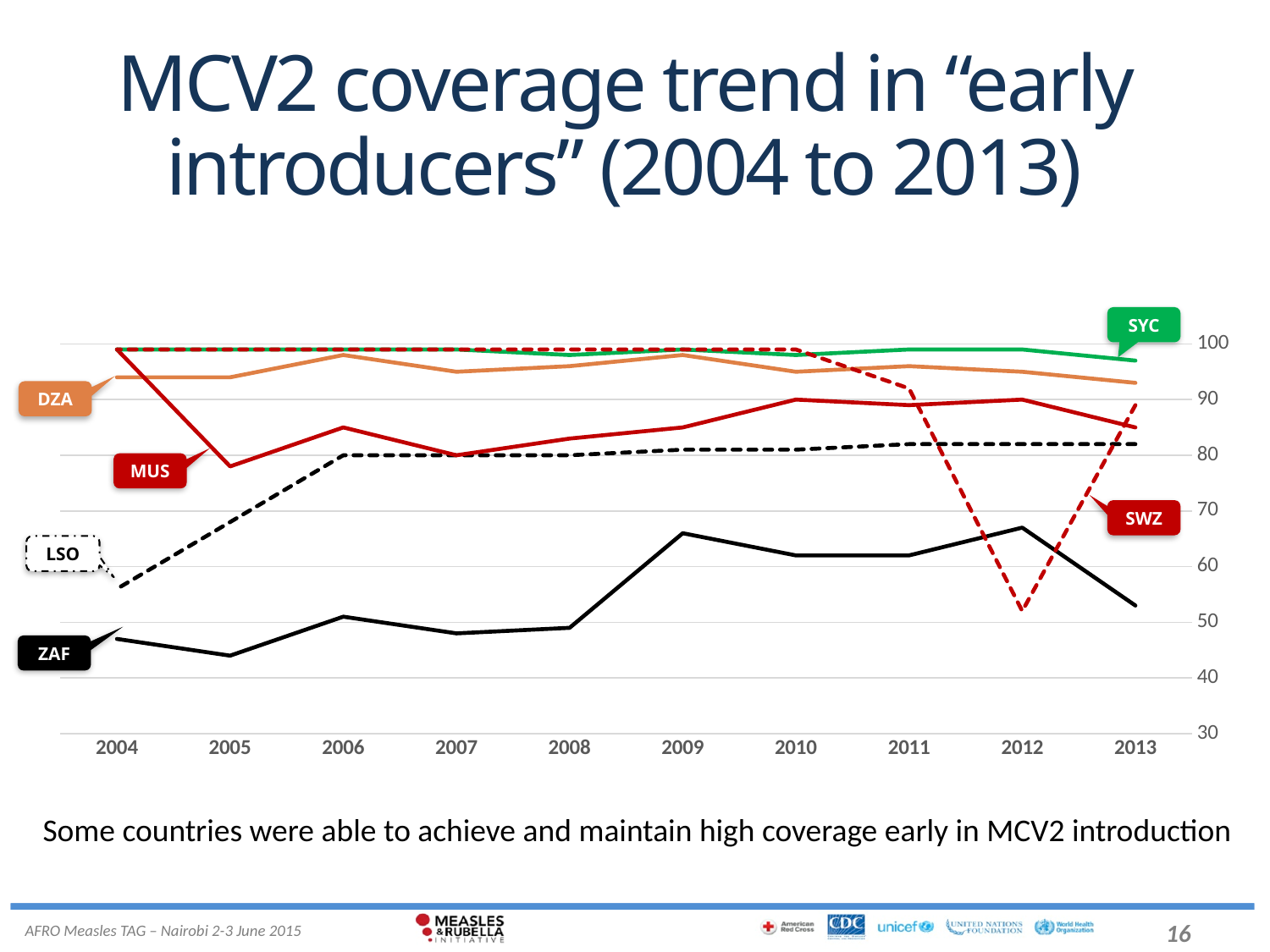
What kind of chart is shown on the slide? line chart What is the title of the chart on the slide? MCV2 coverage trend in "early introducers" (2004 to 2013) Which country has the highest MCV2 coverage in 2013? SYC How many years are shown along the x axis of the chart? 10 Is the value for DZA in 2013 greater or less than 90? greater Is the value for SWZ in 2012 greater or less than 60? less How many countries (series) are plotted on the chart? 6 Does the LSO line rise or fall from 2004 to 2013? rise Is the value for ZAF in 2004 greater or less than 50? less In 2013, which is higher, the value for LSO or the value for ZAF? LSO Which country has the lowest MCV2 coverage in 2004? ZAF